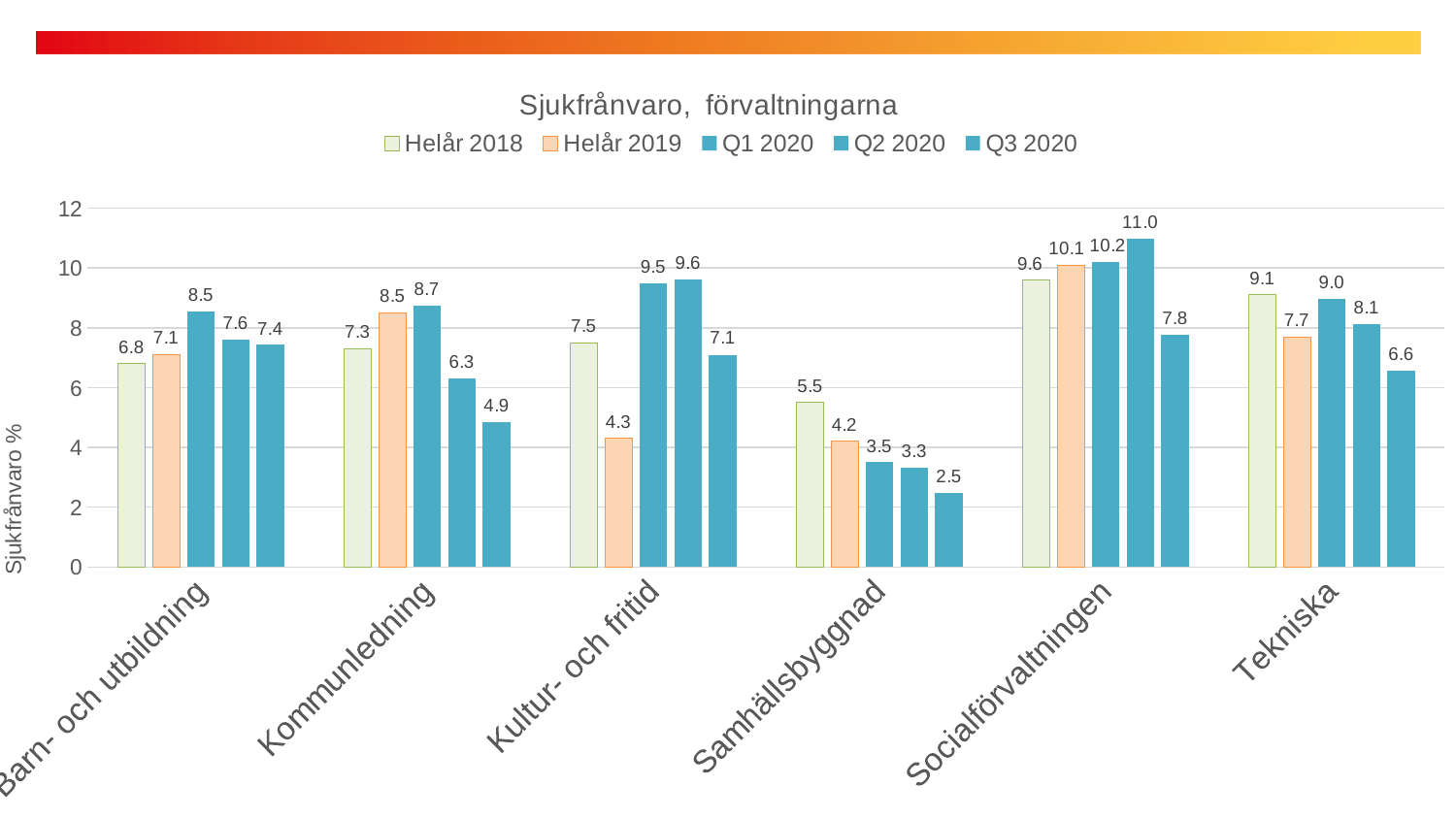
What is the difference between the Helår 2019 values for Kommunledning and Kultur- och fritid? 4.2 What is the Helår 2019 value for Socialförvaltningen? 10.1 Which is larger, the Helår 2018 value for Tekniska or the Helår 2018 value for Kommunledning? Tekniska How many series does the legend list? 5 How many förvaltningar are shown on the x axis? 6 What kind of chart is shown? bar chart What is the Q3 2020 value for Tekniska? 6.6 Which förvaltning has the highest Helår 2018 value? Socialförvaltningen What is the title of the chart? Sjukfrånvaro, förvaltningarna What is the Helår 2018 value for Samhällsbyggnad? 5.5 Is the Q2 2020 value for Socialförvaltningen greater or less than 10? greater Which förvaltning has the lowest Helår 2019 value? Samhällsbyggnad